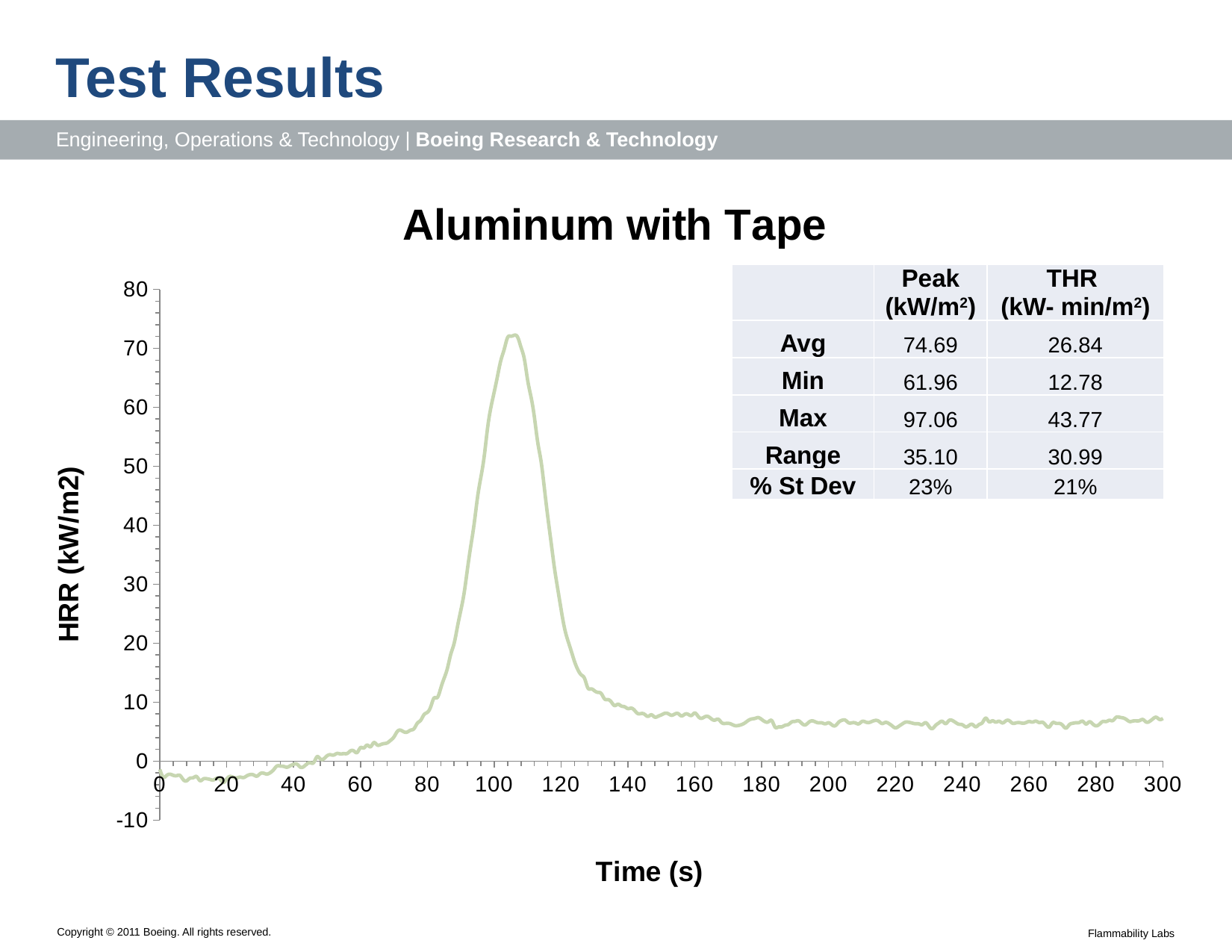
Is the HRR value at 60 s greater or less than 10? less Does the HRR curve rise or fall between 110 s and 140 s? fall Is the HRR value at 200 s greater or less than 10? less What is the label of the y axis of the chart? HRR (kW/m2) Is the peak value of the HRR curve greater or less than 60? greater What is the title of the chart? Aluminum with Tape Does the HRR curve rise or fall between 80 s and 100 s? rise Between which two x-axis tick values does the peak of the HRR curve occur? 100 and 120 What kind of chart is shown on the slide? line chart How many lines (series) are plotted on the chart? 1